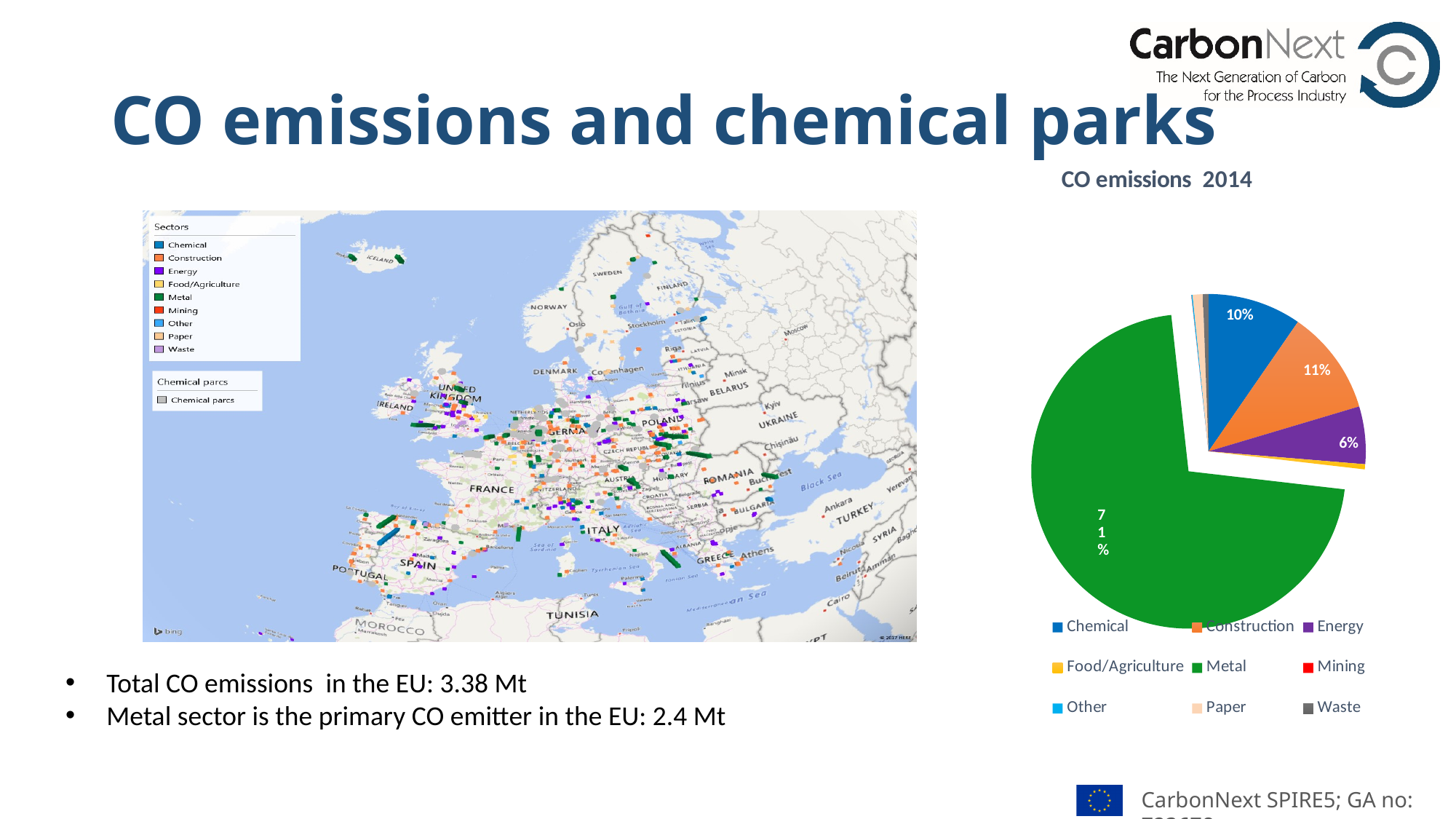
What colour is the Metal slice in the CO emissions 2014 pie chart? green Which sector has the largest slice in the CO emissions 2014 pie chart? Metal What kind of chart is shown on the right of the slide? pie chart What is the title of the pie chart? CO emissions 2014 In the CO emissions 2014 pie chart, what share does Construction have? 11% How many sectors does the legend of the CO emissions 2014 pie chart list? 9 In the CO emissions 2014 pie chart, what share does Chemical have? 10% In the CO emissions 2014 pie chart, what share does Energy have? 6% In the CO emissions 2014 pie chart, what share does Metal have? 71% In the CO emissions 2014 pie chart, what is the difference in percentage points between the Metal and Chemical shares? 61 In the CO emissions 2014 pie chart, which has the larger share, Metal or Energy? Metal In the CO emissions 2014 pie chart, which has the larger share, Construction or Chemical? Construction